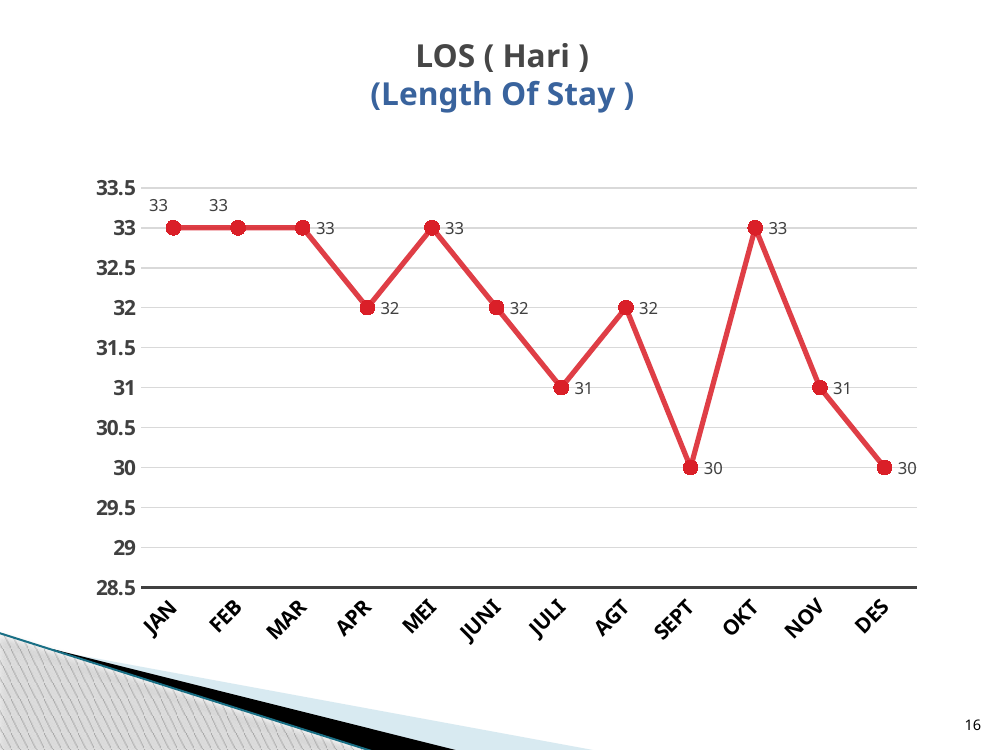
Is the LOS value for AGT greater or less than 31? greater What is the difference between the LOS values for MAR and APR? 1 What is the difference between the LOS values for OKT and NOV? 2 What kind of chart is shown on the slide? line chart What is the LOS value for JULI? 31 What is the title of the chart? LOS ( Hari ) (Length Of Stay ) What is the LOS value for OKT? 33 What is the LOS value for SEPT? 30 How many months are plotted on the chart? 12 What is the LOS value for JAN? 33 Which is larger, the LOS value for MEI or the LOS value for JUNI? MEI Which month has the lowest LOS value? SEPT and DES